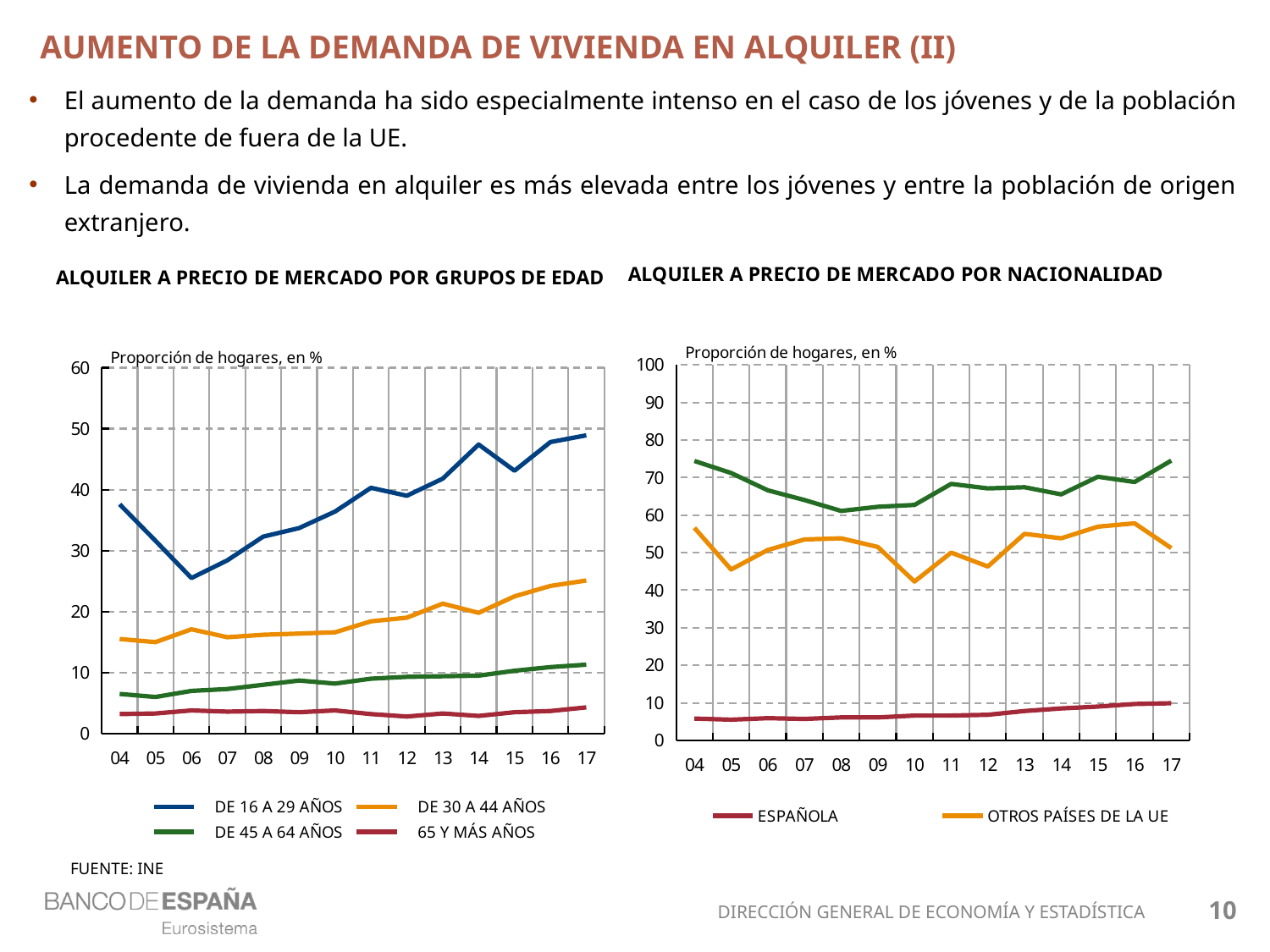
In the 'ALQUILER A PRECIO DE MERCADO POR GRUPOS DE EDAD' chart, is the value for DE 16 A 29 AÑOS in 17 greater or less than 40? greater In the 'ALQUILER A PRECIO DE MERCADO POR GRUPOS DE EDAD' chart, is the value for DE 45 A 64 AÑOS in 04 greater or less than 10? less What kind of chart is the 'ALQUILER A PRECIO DE MERCADO POR GRUPOS DE EDAD' chart? Line chart How many series does the legend of the 'ALQUILER A PRECIO DE MERCADO POR GRUPOS DE EDAD' chart list? 4 How many series does the legend of the 'ALQUILER A PRECIO DE MERCADO POR NACIONALIDAD' chart list? 2 In the 'ALQUILER A PRECIO DE MERCADO POR NACIONALIDAD' chart, does the ESPAÑOLA series rise or fall from 04 to 17? rise In the 'ALQUILER A PRECIO DE MERCADO POR GRUPOS DE EDAD' chart, which age group has the highest value in 17? DE 16 A 29 AÑOS In the 'ALQUILER A PRECIO DE MERCADO POR NACIONALIDAD' chart, is the value for OTROS PAÍSES DE LA UE in 10 greater or less than 50? less In the 'ALQUILER A PRECIO DE MERCADO POR GRUPOS DE EDAD' chart, which age group has the lowest value in 17? 65 Y MÁS AÑOS How many years are shown on the x axis of the 'ALQUILER A PRECIO DE MERCADO POR GRUPOS DE EDAD' chart? 14 In the 'ALQUILER A PRECIO DE MERCADO POR GRUPOS DE EDAD' chart, is the value for DE 16 A 29 AÑOS larger in 04 or in 06? 04